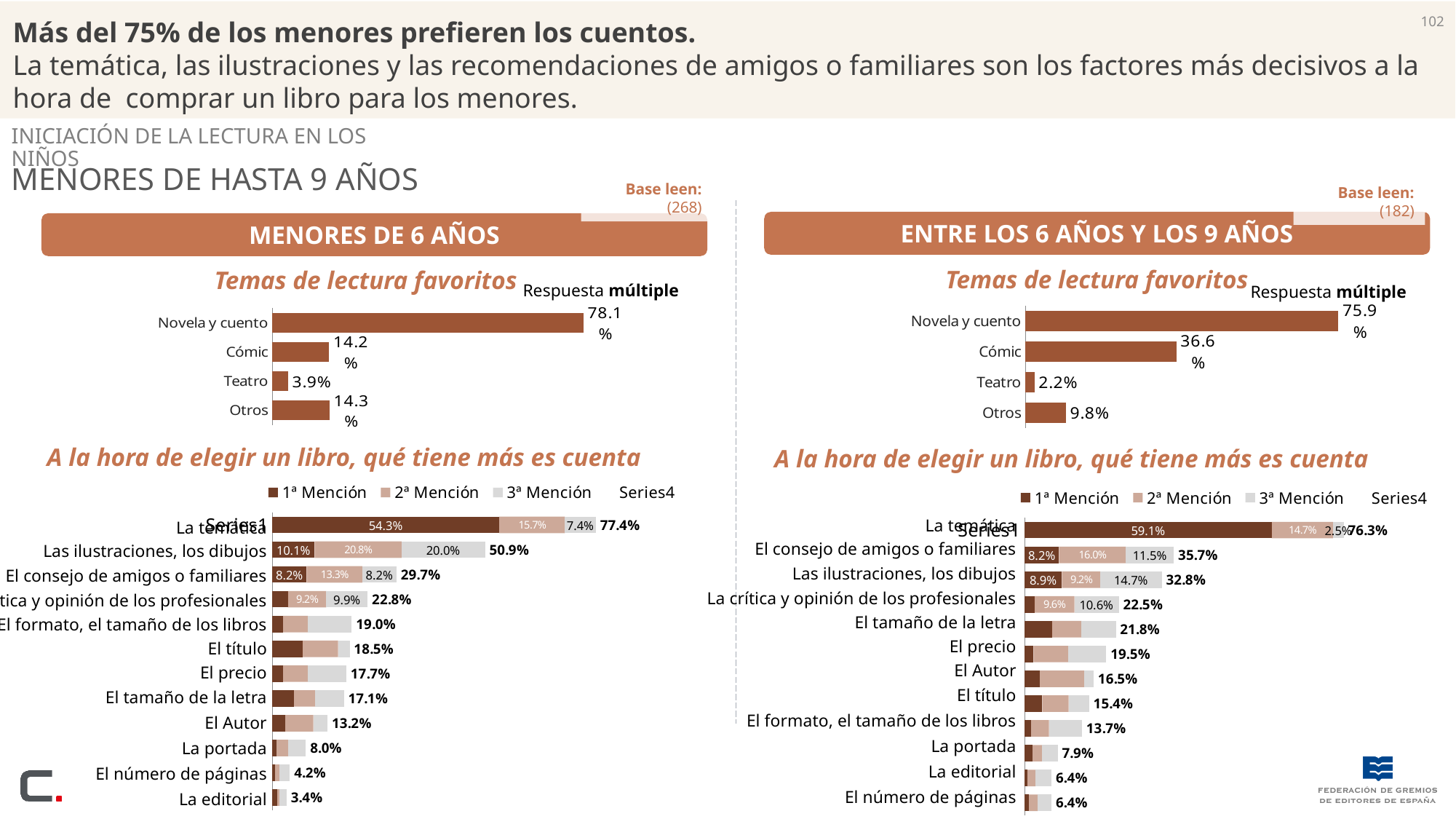
In the 'A la hora de elegir un libro' chart for Entre los 6 años y los 9 años, what is the total for El consejo de amigos o familiares? 35.7% In the 'Temas de lectura favoritos' chart for Menores de 6 años, how many categories are shown? 4 In the 'A la hora de elegir un libro' chart for Entre los 6 años y los 9 años, which is larger, the total for El precio or the total for El Autor? El precio In the 'Temas de lectura favoritos' chart for Menores de 6 años, which category has the lowest value? Teatro In the 'A la hora de elegir un libro' chart for Menores de 6 años, what is the total for Las ilustraciones, los dibujos? 50.9% In the 'Temas de lectura favoritos' chart for Entre los 6 años y los 9 años, what is the difference between Novela y cuento and Cómic? 39.3% What type of chart is the 'Temas de lectura favoritos' chart for Menores de 6 años? Bar chart In the 'Temas de lectura favoritos' chart for Entre los 6 años y los 9 años, what is the value for Cómic? 36.6% In the 'A la hora de elegir un libro' chart for Menores de 6 años, what is the 1ª Mención value for La temática? 54.3% In the 'Temas de lectura favoritos' chart for Entre los 6 años y los 9 años, which category has the highest value? Novela y cuento In the 'Temas de lectura favoritos' chart for Menores de 6 años, what is the value for Novela y cuento? 78.1% In the 'A la hora de elegir un libro' chart for Menores de 6 años, how many categories are listed? 12